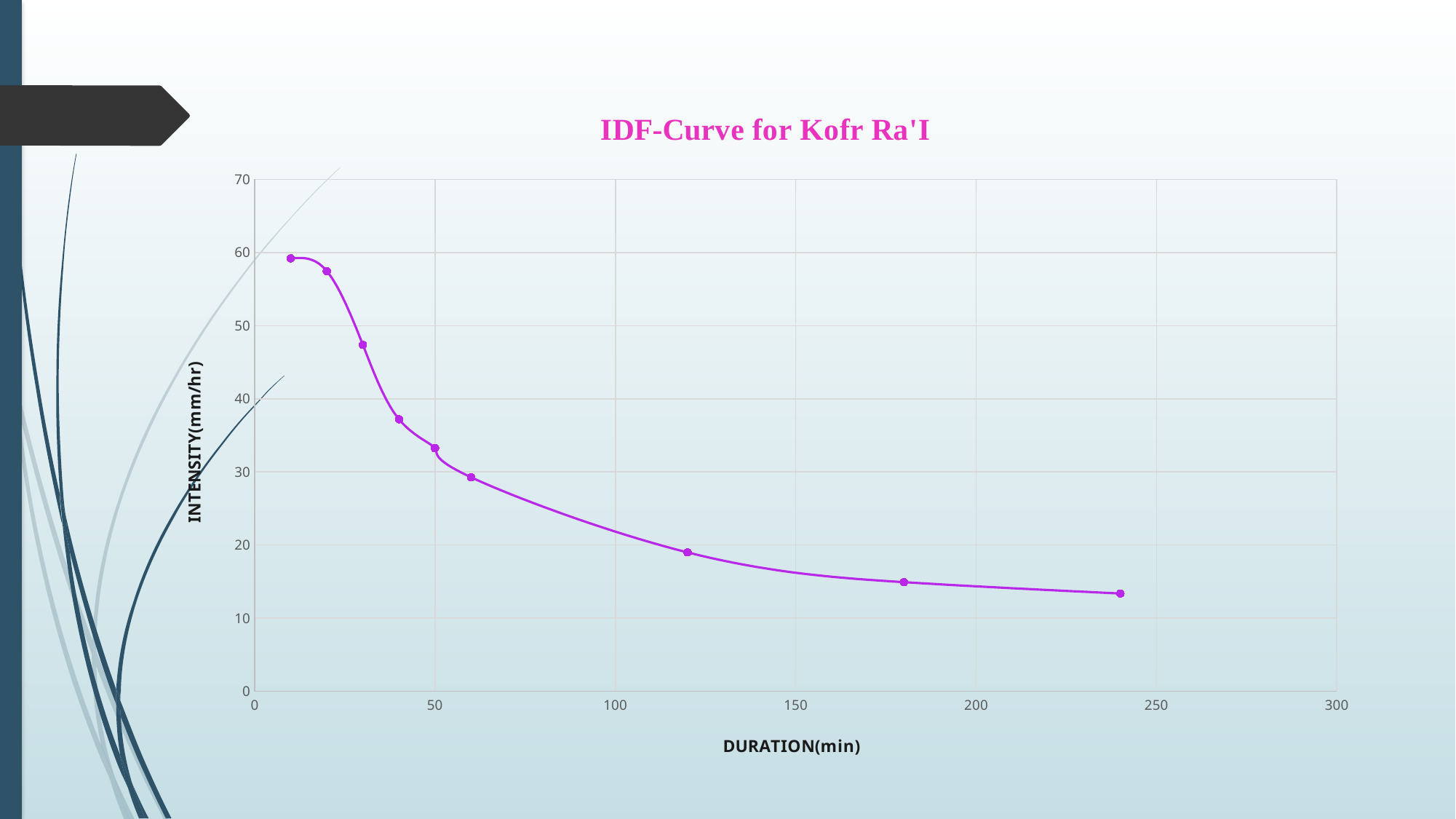
What is the title of the chart? IDF-Curve for Kofr Ra'I Is the intensity value at a duration of 30 min greater or less than 50? less Is the intensity value at a duration of 120 min greater or less than 20? less What kind of chart is shown on the slide? line chart Is the intensity value at a duration of 10 min greater or less than 50? greater What is the label of the y axis? INTENSITY(mm/hr) Do the intensity values rise or fall as duration increases along the x axis? fall How many data points are plotted on the curve? 9 At which duration is the intensity highest? 10 min Which has the larger intensity: the point at 50 min or the point at 180 min? 50 min